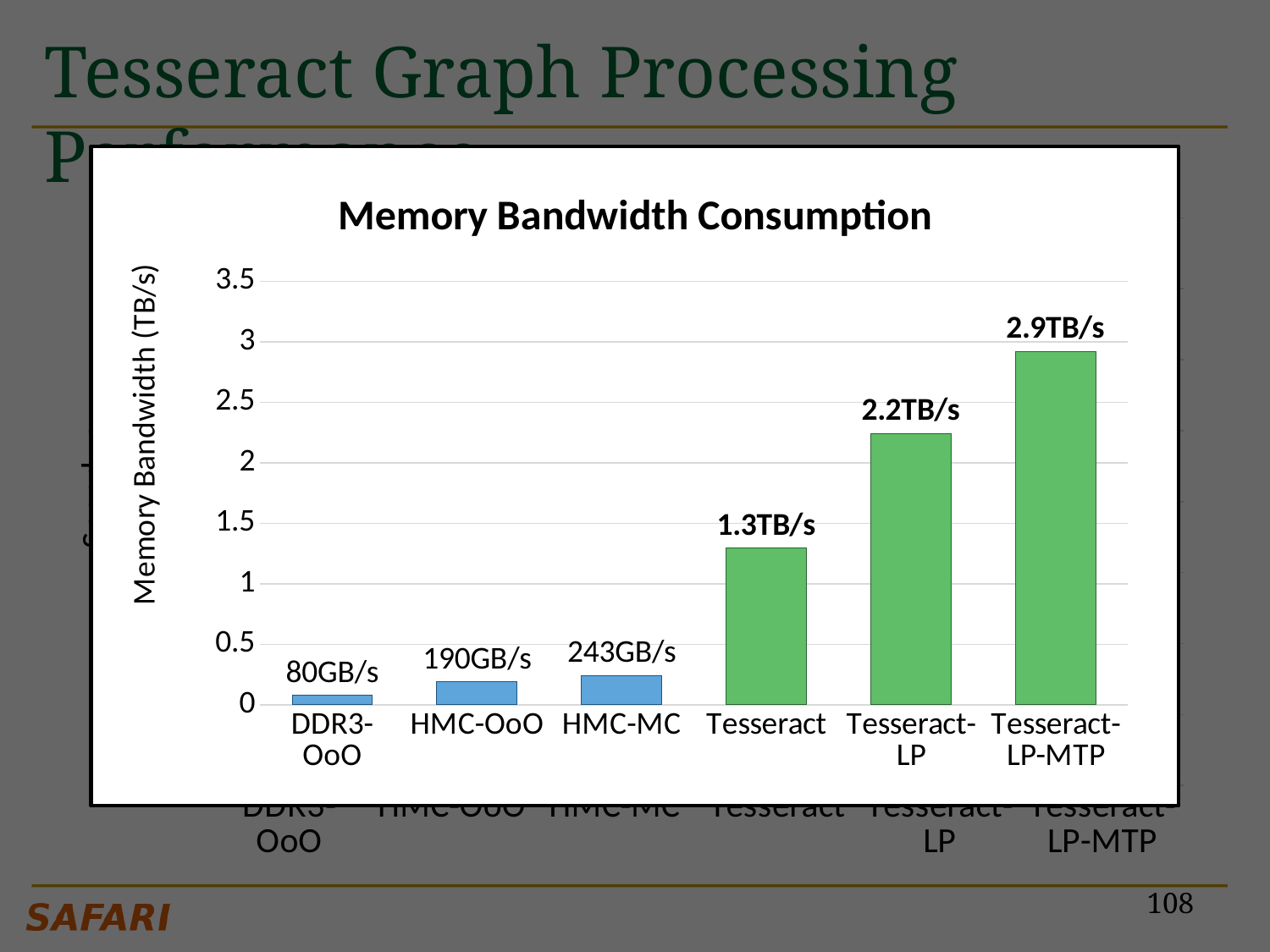
What is the difference in memory bandwidth between Tesseract-LP-MTP and Tesseract-LP? 0.7TB/s What is the memory bandwidth value shown for Tesseract-LP-MTP? 2.9TB/s Which category has the highest memory bandwidth consumption? Tesseract-LP-MTP How many categories are shown on the x axis of the chart? 6 What type of chart is used to show Memory Bandwidth Consumption? bar chart What is the difference in memory bandwidth between HMC-MC and HMC-OoO? 53GB/s What is the memory bandwidth value shown for HMC-MC? 243GB/s Is the value for Tesseract-LP greater or less than 2 TB/s? greater Which category has the lowest memory bandwidth consumption? DDR3-OoO What is the memory bandwidth value shown for Tesseract? 1.3TB/s What is the memory bandwidth value shown for DDR3-OoO? 80GB/s Which has a higher memory bandwidth, HMC-OoO or Tesseract? Tesseract